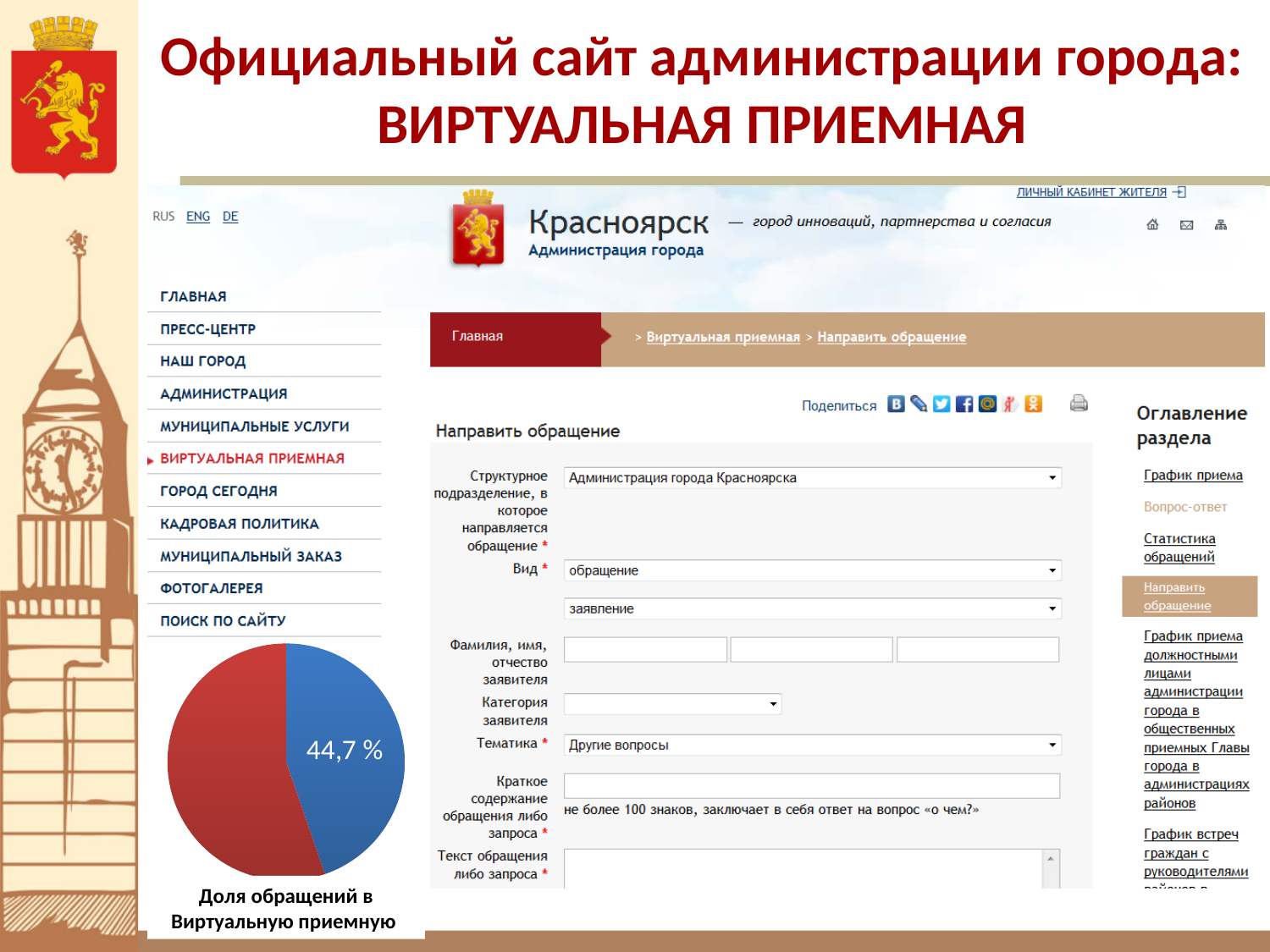
Which slice of the pie chart is larger, the red one or the blue one? the red one What is the caption written under the pie chart? Доля обращений в Виртуальную приемную Which slice of the pie chart is the smallest? the blue slice What kind of chart is shown at the bottom left of the slide? pie chart Which slice of the pie chart is the largest? the red slice What two colours are used for the slices of the pie chart? red and blue Is the value of the blue slice of the pie chart greater or less than 50%? less How many slices does the pie chart have? 2 What value is printed on the blue slice of the pie chart? 44,7 %